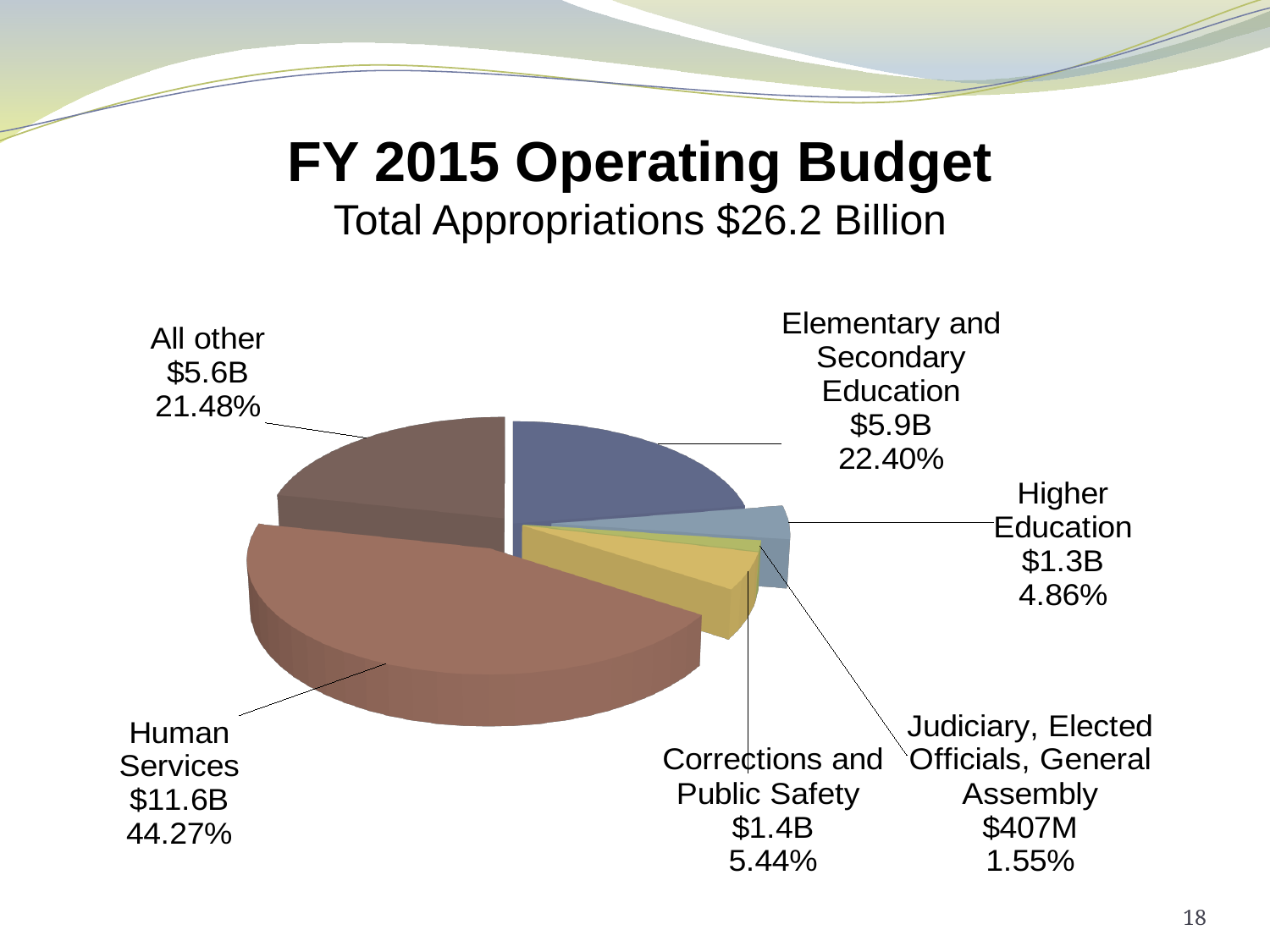
What percentage share does Corrections and Public Safety have? 5.44% What total appropriations amount is stated in the chart's subtitle? $26.2 Billion Which category has the largest share of the pie? Human Services What is the dollar amount for Human Services? $11.6B Which category has the smallest share of the pie? Judiciary, Elected Officials, General Assembly Which is larger, the share for All other or the share for Elementary and Secondary Education? Elementary and Secondary Education How many categories are shown in the pie chart? 6 What percentage share does Elementary and Secondary Education have? 22.40% What kind of chart is shown on the slide? Pie chart What is the difference in percentage points between Human Services (44.27%) and All other (21.48%)? 22.79 What is the dollar amount for Higher Education? $1.3B What is the dollar amount for Judiciary, Elected Officials, General Assembly? $407M